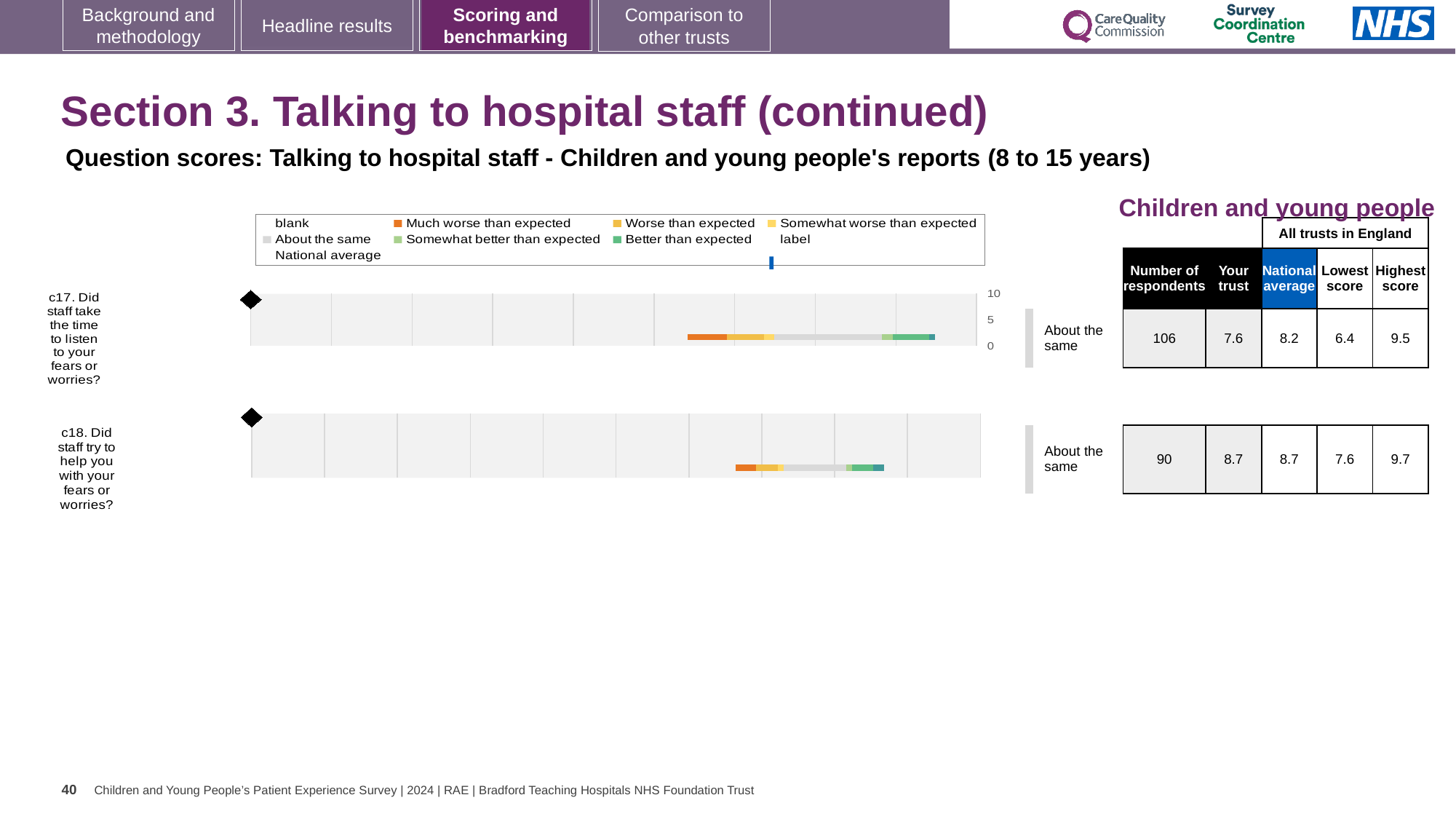
What is the lowest score among all trusts in England for question c17? 6.4 What benchmark category is shown for question c17? About the same Which question has the higher 'Your trust' score, c17 or c18? c18 By how much does the national average exceed the trust's score for question c17? 0.6 What is the national average score for question c18 (Did staff try to help you with your fears or worries?)? 8.7 What is the 'Your trust' score for question c17 (Did staff take the time to listen to your fears or worries?)? 7.6 What kind of chart is used to show the benchmarking for each question? Bar chart How many respondents answered question c17? 106 What is the difference between the highest and lowest scores for question c18? 2.1 What is the highest score among all trusts in England for question c18? 9.7 How many survey questions are plotted on this slide? 2